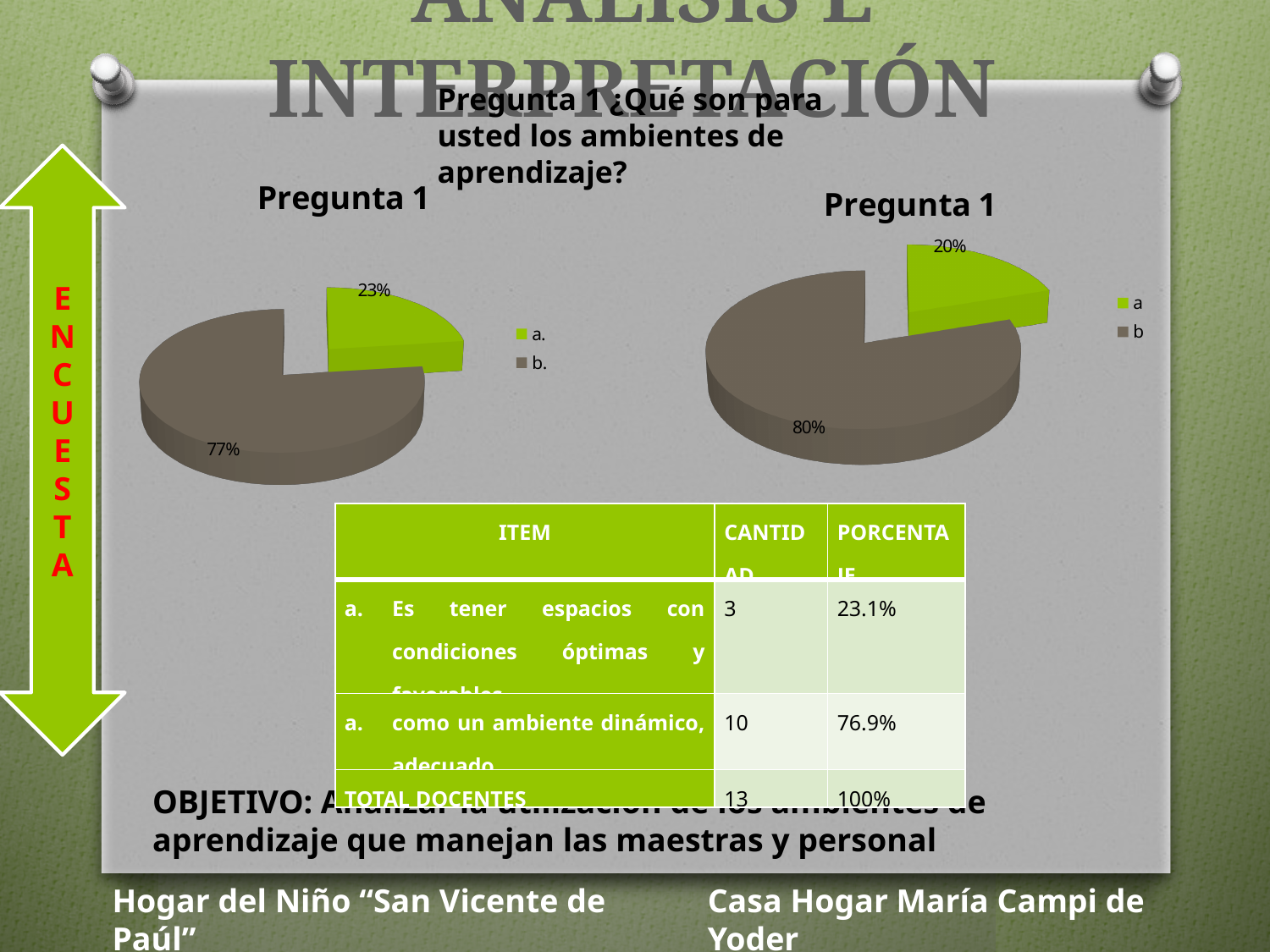
In the right pie chart, which slice is the smallest? a What type of chart is the left chart on the slide? Pie chart In the right pie chart, what is the share for slice b? 80% How many entries does the legend of the right pie chart list? 2 In the left pie chart, what is the share for slice a.? 23% In the right pie chart, what is the difference between the shares of b and a? 60% How many slices does the left pie chart have? 2 In the left pie chart, what is the share for slice b.? 77% In the left pie chart, which slice is the largest? b. In the left pie chart, what is the difference between the shares of b. and a.? 54% In the right pie chart, which slice is larger, a or b? b